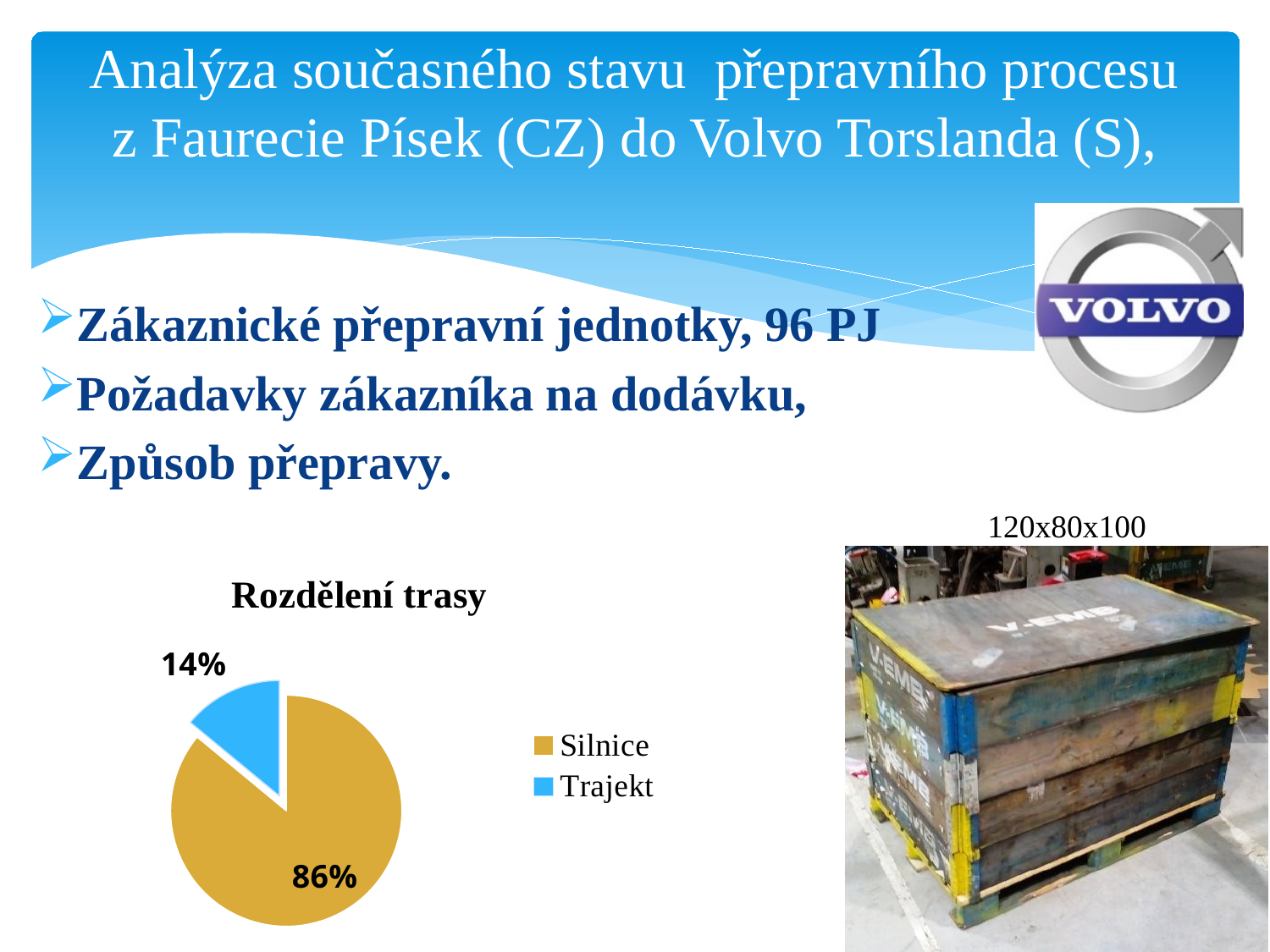
Which category has the largest share of the pie? Silnice What is the title of the pie chart? Rozdělení trasy What share of the pie does Trajekt have? 14% How many categories does the pie chart have? 2 What colour is the Trajekt slice? blue What is the difference between the shares of Silnice and Trajekt? 72% How many entries does the legend list? 2 What is the total of the two slices shown? 100% Which is larger, the share for Silnice or the share for Trajekt? Silnice What share of the pie does Silnice have? 86% What type of chart is shown on the slide? pie chart Which category has the smallest share of the pie? Trajekt